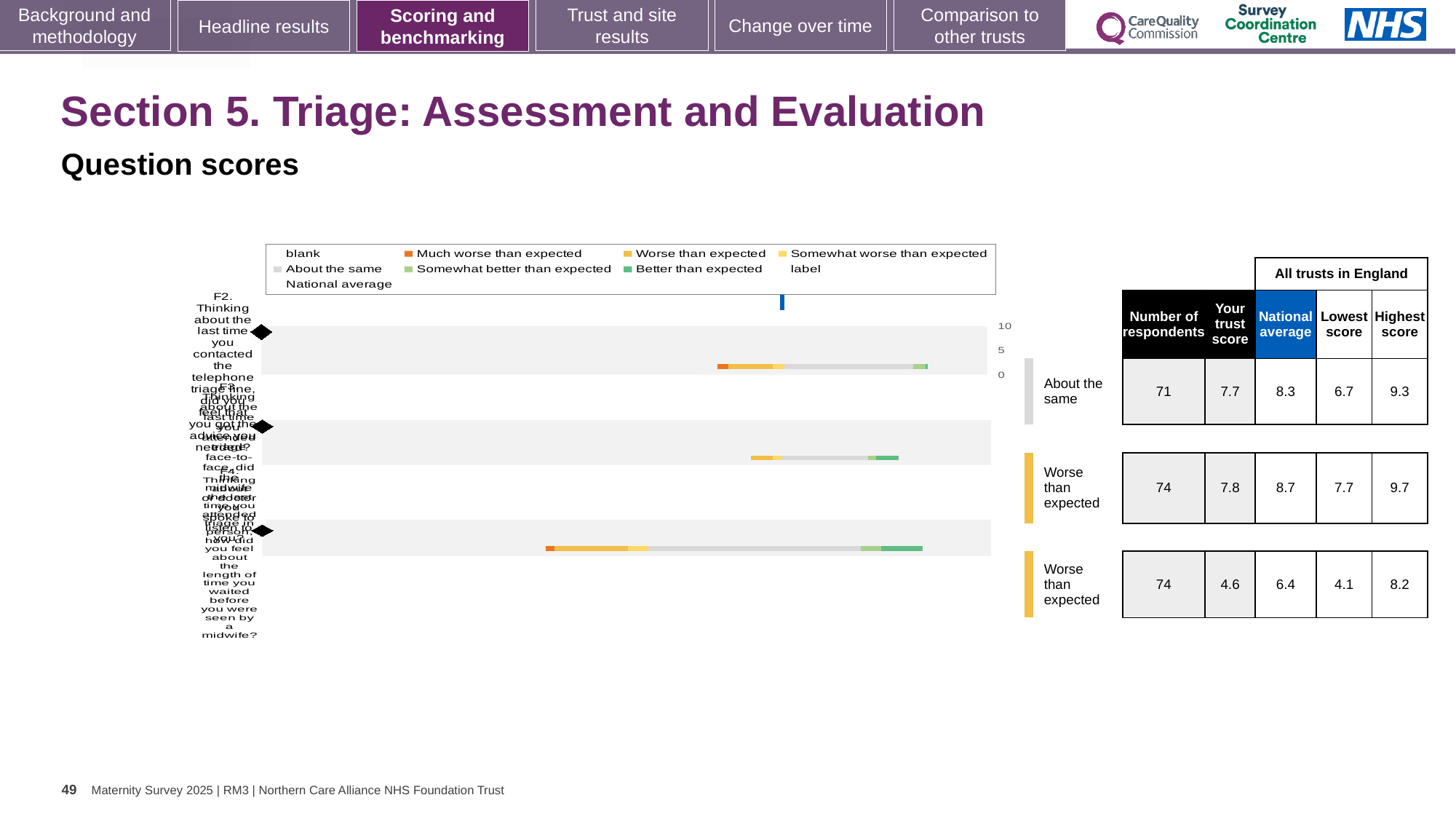
In the table beside the chart, what is the national average for the second (middle) question row? 8.7 For the third (bottom) question row, what is the difference between the national average and 'Your trust score'? 1.8 In the table beside the chart, what is 'Your trust score' for the third (bottom) question row? 4.6 In the table beside the chart, what is the highest score for the third (bottom) question row? 8.2 In the table beside the chart, what is the number of respondents for the first (top) question row? 71 Which question row has the lowest 'Your trust score' in the table beside the chart? the third (bottom) row, 4.6 In the chart legend, what colour represents 'Much worse than expected'? orange Is 'Your trust score' for the third (bottom) question row greater or less than 5? less What kind of chart is shown on the slide? bar chart How many question rows (categories) are plotted in the chart? 3 What benchmark label is shown for the first (top) question row in the chart? About the same What benchmark label is shown for the third (bottom) question row in the chart? Worse than expected